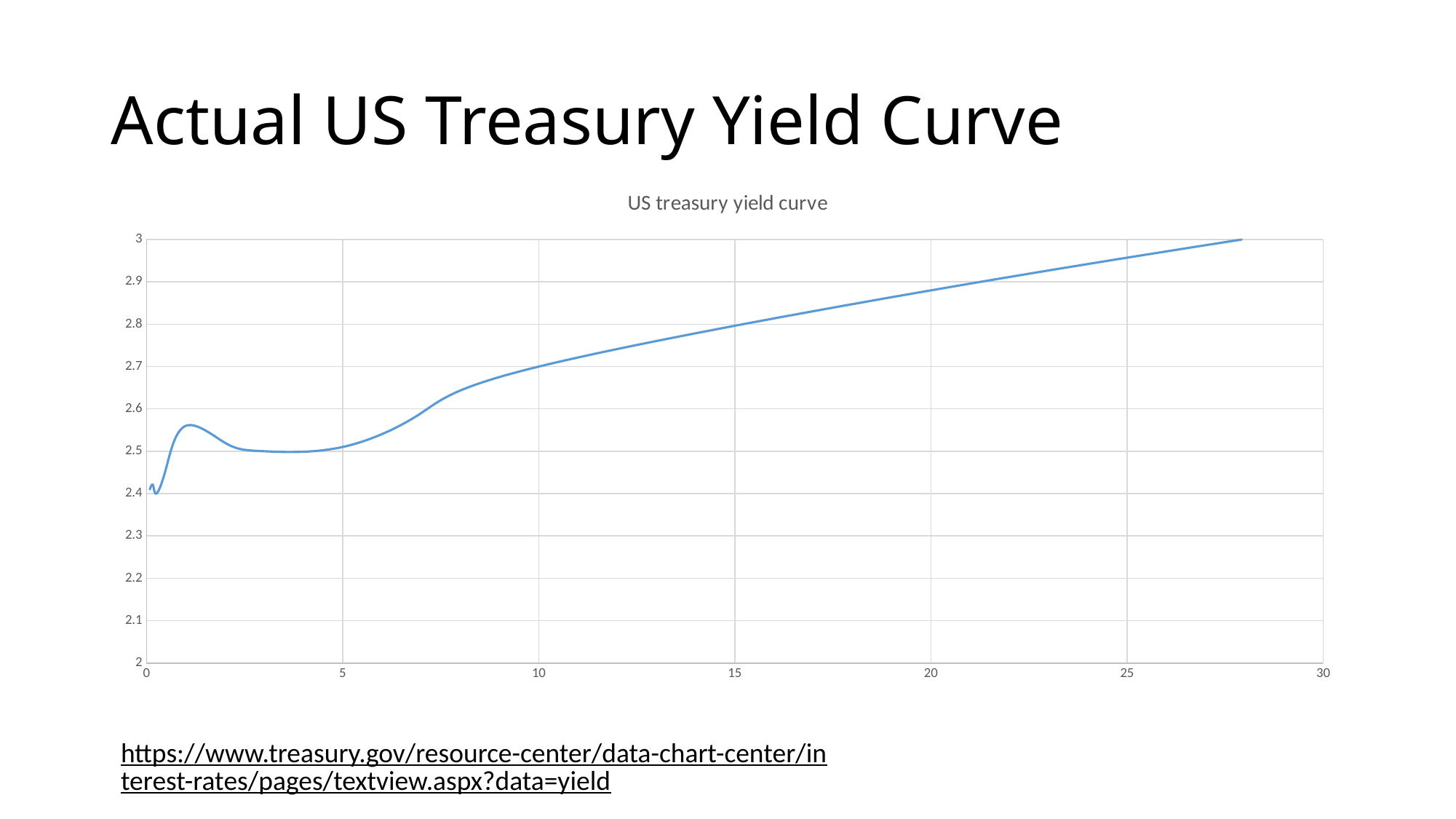
Is the value of the curve at x = 25 greater or less than 2.9? greater What is the title of the chart? US treasury yield curve What kind of chart is shown on the slide? line chart Which is larger: the value of the curve at x = 1 or at x = 3? x = 1 What is the highest value shown on the y-axis? 3 Is the value of the curve at x = 10 greater or less than 2.6? greater How many lines are plotted on the chart? 1 Is the value of the curve at x = 15 greater or less than 2.7? greater Overall, does the yield curve rise or fall as the x-axis value increases from 5 to 30? rise Which is larger: the value of the curve at x = 25 or at x = 5? x = 25